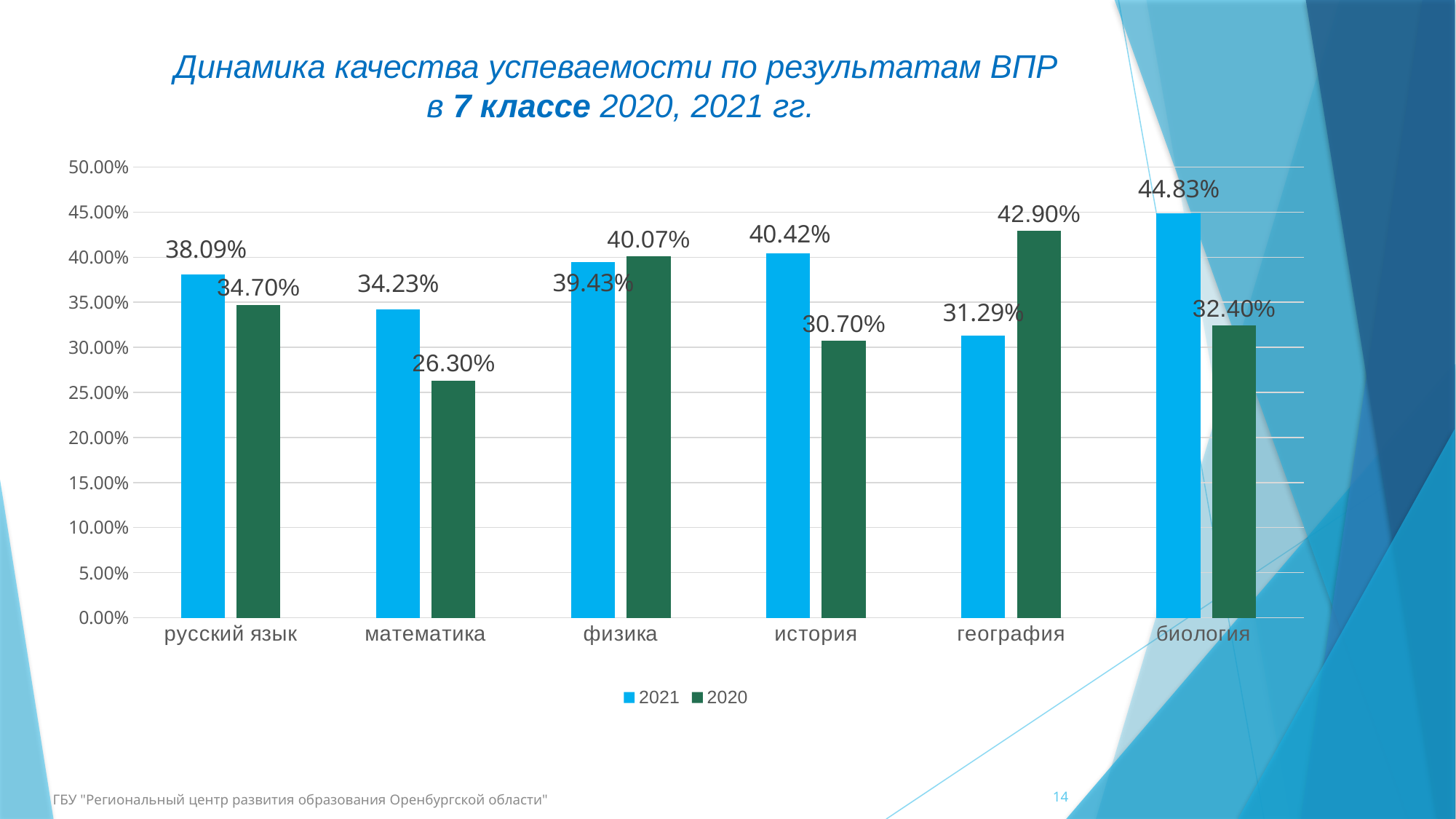
What is the 2020 value for математика? 26.30% Which subject has the lowest 2020 value? математика What is the difference between the 2021 and 2020 values for биология? 12.43% What is the 2020 value for география? 42.90% Which is larger for география: the 2021 value or the 2020 value? 2020 What kind of chart is shown on the slide? bar chart How many subjects are shown on the x axis? 6 Which subject has the highest 2021 value? биология Which colour represents the 2020 series in the legend? green Is the 2021 value for русский язык greater or less than 35.00%? greater How many series does the legend list? 2 What is the 2021 value for история? 40.42%